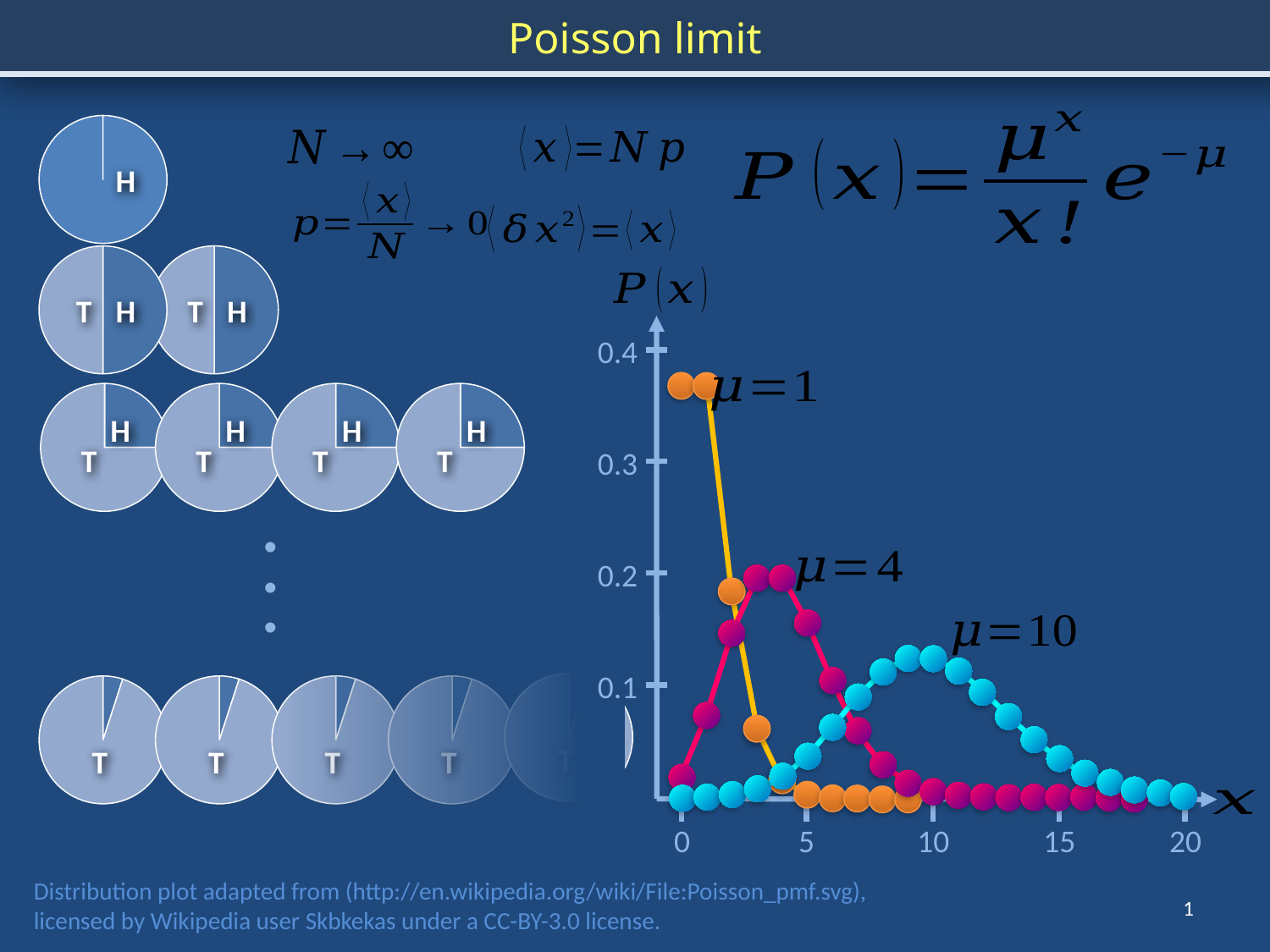
Which series has the lowest peak value of P(x)? μ=10 How many distributions (series) are plotted on the chart? 3 Is the value of the μ=1 series at x=10 greater or less than 0.1? less Which series has the larger value at x=15, μ=4 or μ=10? μ=10 What is the largest tick value labelled on the x axis? 20 Is the peak value of the μ=1 series greater or less than 0.3? greater Which series has the highest peak value of P(x)? μ=1 Is the peak value of the μ=10 series greater or less than 0.2? less What is the label on the vertical axis of the chart? P(x) Does the μ=1 series rise or fall as x increases from 1 to 5? fall